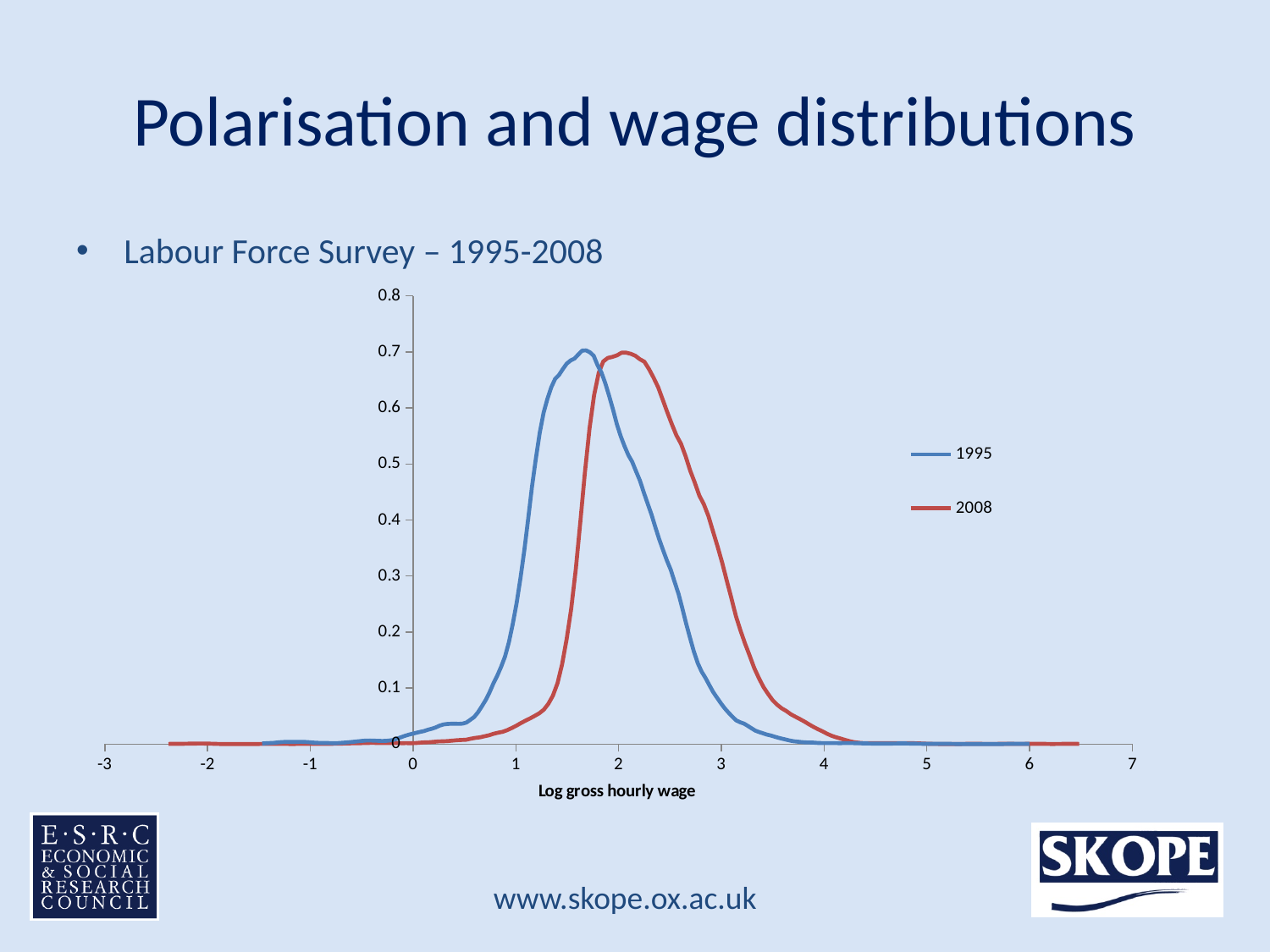
What are the two series named in the legend? 1995 and 2008 Is the peak value of the 1995 series greater or less than 0.6? greater Is the value of the 1995 series at a log gross hourly wage of 3 greater or less than 0.2? less Is the value of the 2008 series at a log gross hourly wage of 1 greater or less than 0.1? less How many series does the legend list? 2 At a log gross hourly wage of 3, which series has the larger value, 1995 or 2008? 2008 At a log gross hourly wage of 1, which series has the larger value, 1995 or 2008? 1995 What kind of chart is shown on the slide? line chart What is the title of the x axis? Log gross hourly wage Between a log gross hourly wage of 2 and 3, does the 1995 series rise or fall? fall